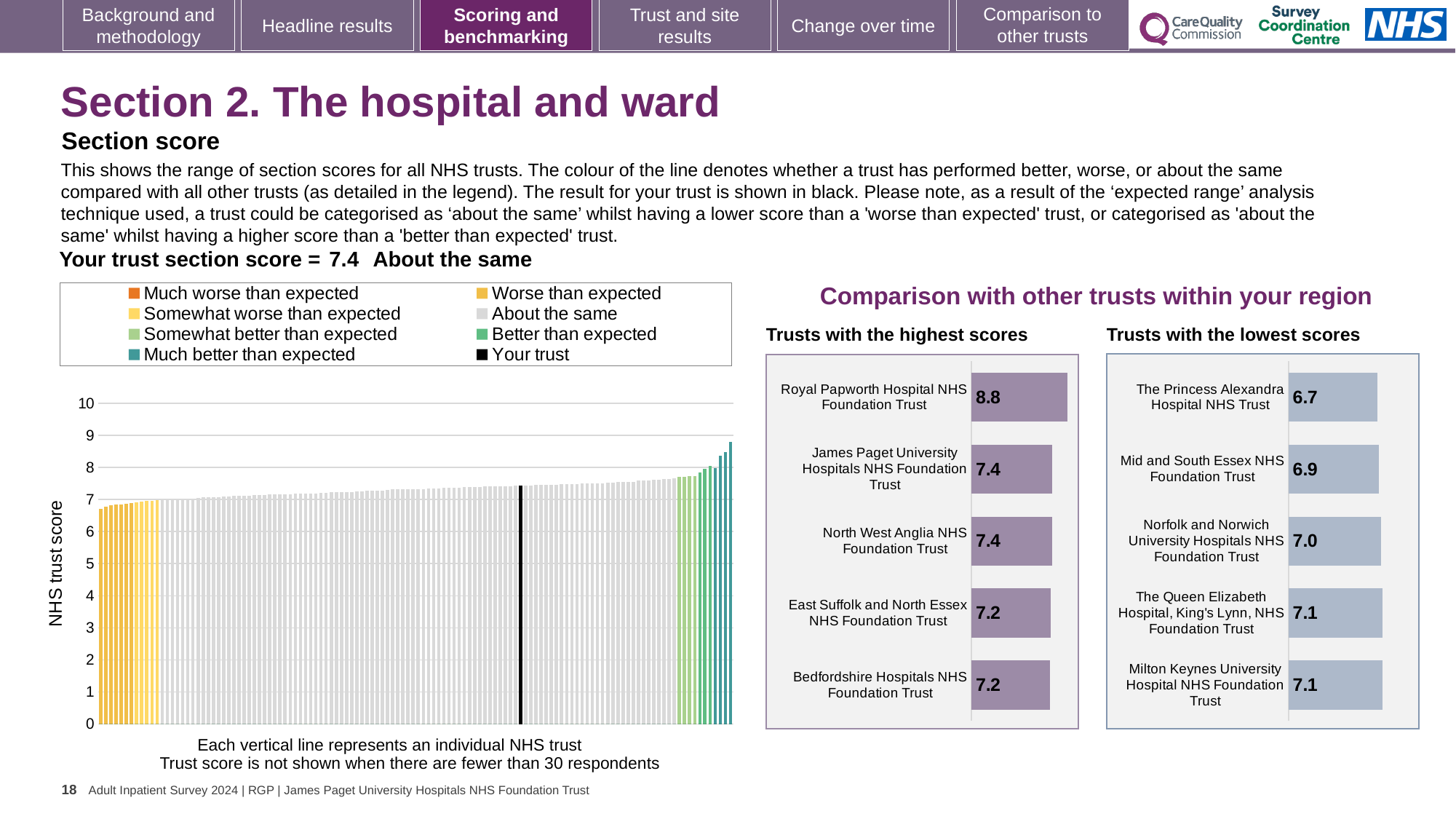
In the 'Trusts with the lowest scores' chart, what is the score for Milton Keynes University Hospital NHS Foundation Trust? 7.1 In the 'Trusts with the highest scores' chart, what is the difference between the scores of Royal Papworth Hospital NHS Foundation Trust and Bedfordshire Hospitals NHS Foundation Trust? 1.6 In the 'Trusts with the lowest scores' chart, what is the difference between the scores of Norfolk and Norwich University Hospitals NHS Foundation Trust and Mid and South Essex NHS Foundation Trust? 0.1 In the 'Trusts with the lowest scores' chart, which trust has the lowest score? The Princess Alexandra Hospital NHS Trust How many trusts are shown in the 'Trusts with the lowest scores' chart? 5 In the 'Trusts with the lowest scores' chart, what is the score for The Princess Alexandra Hospital NHS Trust? 6.7 In the 'Trusts with the highest scores' chart, what is the score for Royal Papworth Hospital NHS Foundation Trust? 8.8 In the 'Trusts with the highest scores' chart, which has the larger score: Royal Papworth Hospital NHS Foundation Trust or East Suffolk and North Essex NHS Foundation Trust? Royal Papworth Hospital NHS Foundation Trust What kind of chart is the large chart on the left showing NHS trust scores? Bar chart In the 'Trusts with the highest scores' chart, which trust has the highest score? Royal Papworth Hospital NHS Foundation Trust In the large chart on the left, do the trust scores rise or fall from left to right? Rise How many entries does the legend of the large chart on the left list? 8